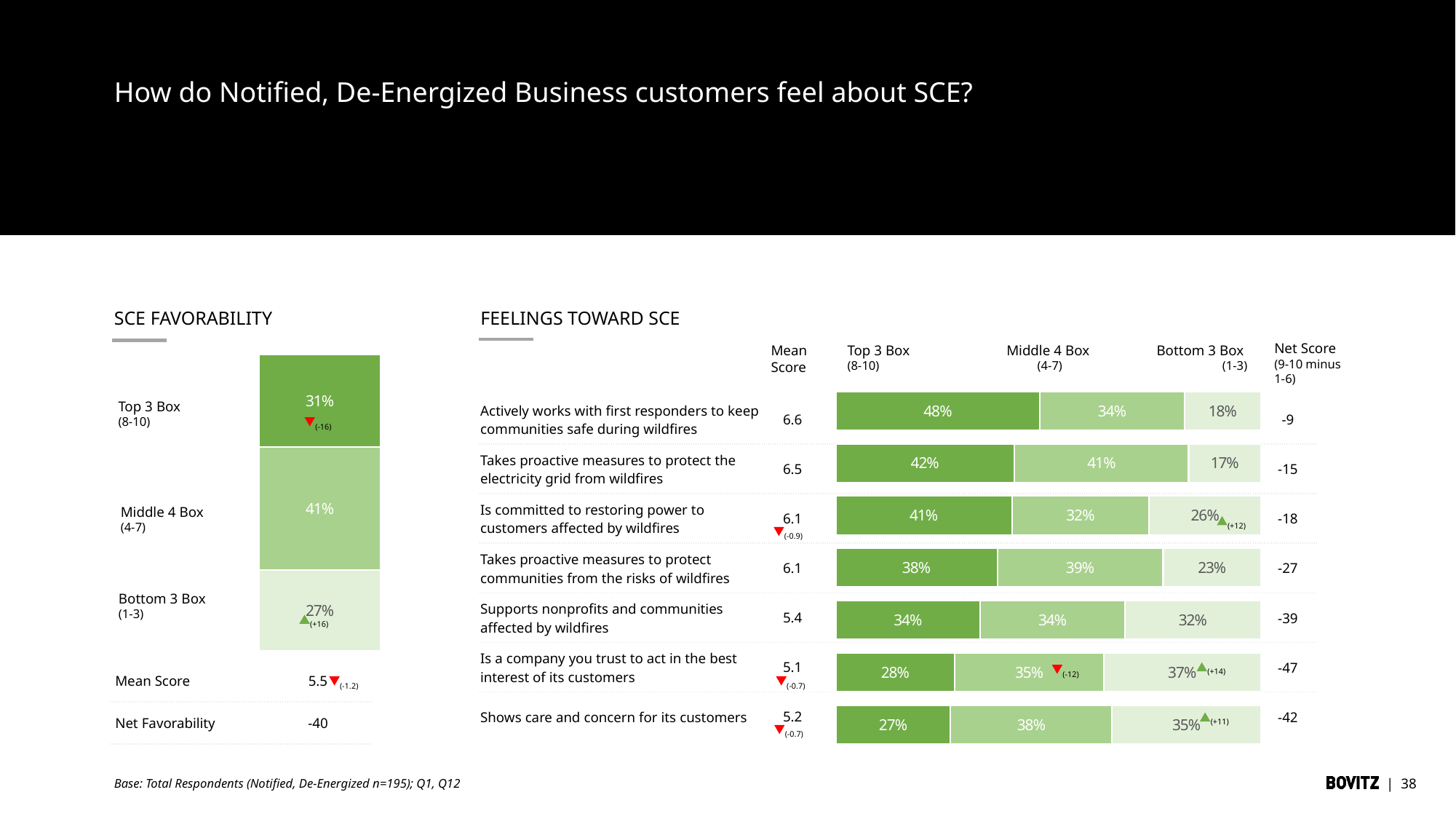
In the FEELINGS TOWARD SCE chart, what is the Net Score for 'Is a company you trust to act in the best interest of its customers'? -47 In the FEELINGS TOWARD SCE chart, which statement has the highest Top 3 Box percentage? Actively works with first responders to keep communities safe during wildfires How many statements are shown in the FEELINGS TOWARD SCE chart? 7 In the FEELINGS TOWARD SCE chart, which is larger: the Bottom 3 Box percentage for 'Takes proactive measures to protect communities from the risks of wildfires' or for 'Takes proactive measures to protect the electricity grid from wildfires'? Takes proactive measures to protect communities from the risks of wildfires In the FEELINGS TOWARD SCE chart, what is the difference between the Top 3 Box and Bottom 3 Box percentages for 'Takes proactive measures to protect the electricity grid from wildfires'? 25% In the FEELINGS TOWARD SCE chart, which statement has the lowest Top 3 Box percentage? Shows care and concern for its customers In the SCE FAVORABILITY chart, which box has the lowest percentage? Bottom 3 Box (1-3) In the FEELINGS TOWARD SCE chart, what is the Top 3 Box percentage for 'Actively works with first responders to keep communities safe during wildfires'? 48% In the FEELINGS TOWARD SCE chart, what is the Mean Score for 'Supports nonprofits and communities affected by wildfires'? 5.4 In the SCE FAVORABILITY chart, what percentage of customers are in the Middle 4 Box (4-7)? 41% What type of chart is the FEELINGS TOWARD SCE chart? Stacked bar chart In the SCE FAVORABILITY chart, what is the difference between the Middle 4 Box and Top 3 Box percentages? 10%